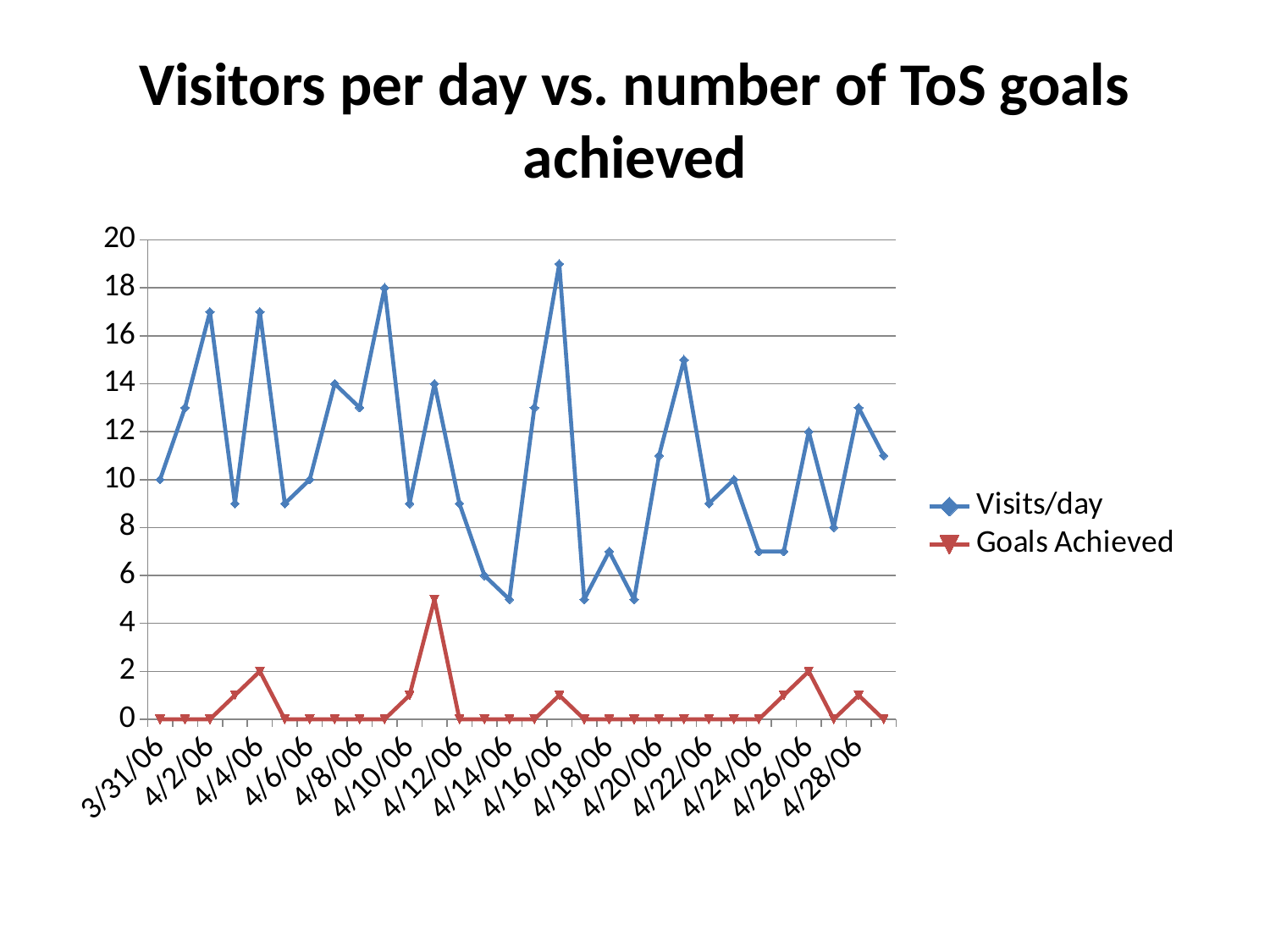
What is the Goals Achieved value on 4/26/06? 2 On which date does Visits/day reach its highest value? 4/16/06 What is the title of the chart? Visitors per day vs. number of ToS goals achieved What is the Visits/day value on 4/26/06? 12 What kind of chart is shown on the slide? line chart Which series is drawn in red? Goals Achieved What is the Visits/day value on 3/31/06? 10 Is the Visits/day value on 4/14/06 greater or less than 8? less On 4/26/06, what is the difference between Visits/day and Goals Achieved? 10 How many series does the legend list? 2 Is the Visits/day value on 4/16/06 greater or less than 18? greater What is the Goals Achieved value on 3/31/06? 0